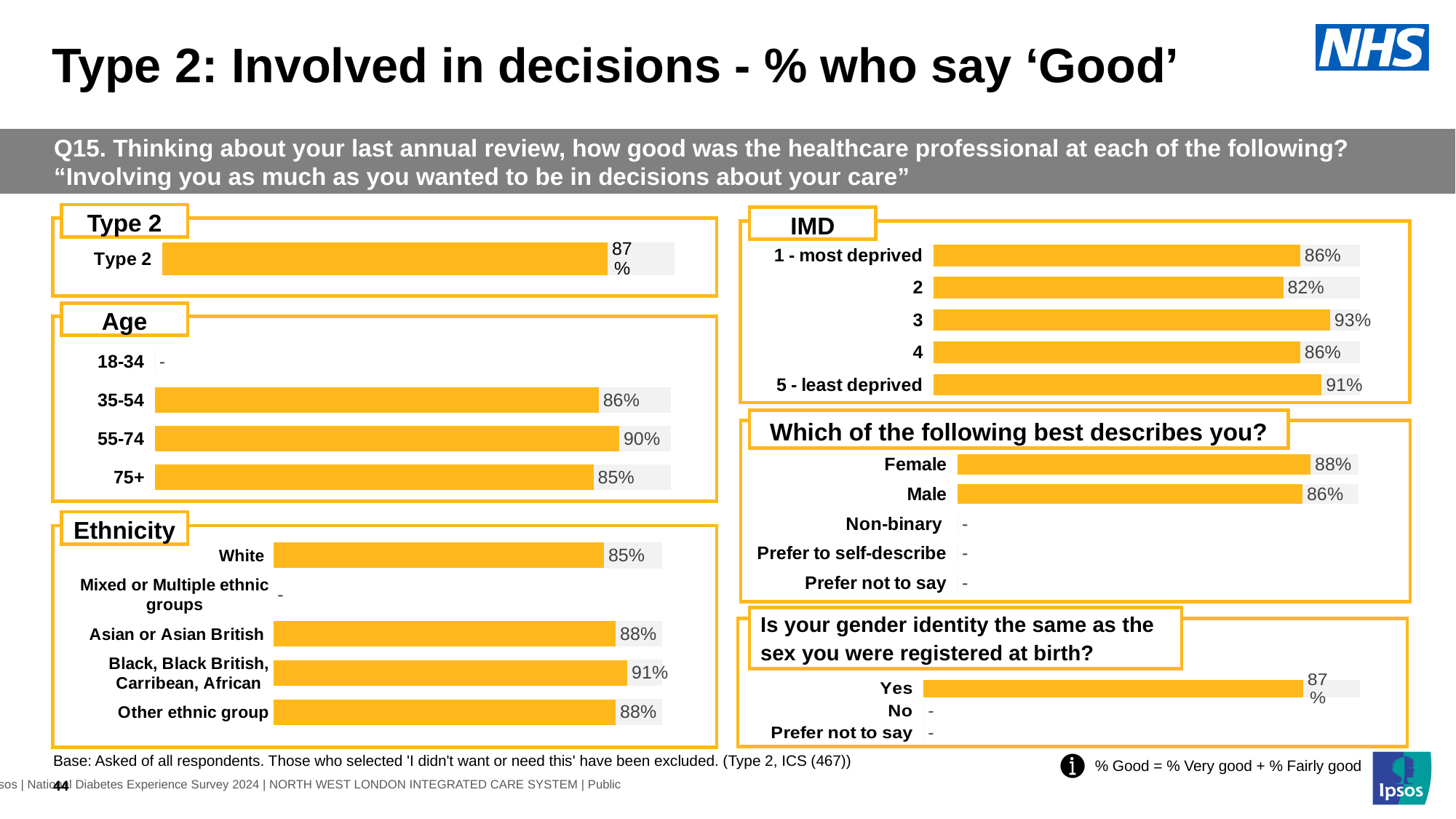
In the 'Which of the following best describes you?' chart, which is larger, Female or Male? Female In the Age chart, which age group with a plotted value has the lowest percentage? 75+ In the Age chart, what is the value for the 55-74 age group? 90% In the Age chart, what is the difference between the 55-74 and 35-54 values? 4 percentage points In the 'Is your gender identity the same as the sex you were registered at birth?' chart, what is the value for Yes? 87% In the IMD chart, what is the difference between the values for 3 and 2? 11 percentage points What type of chart is used in the IMD section? Bar chart In the Ethnicity chart, which ethnic group has the highest percentage? Black, Black British, Carribean, African In the Ethnicity chart, what is the value for White respondents? 85% In the IMD chart, which IMD group has the highest percentage? 3 In the Type 2 chart, what percentage of Type 2 respondents say 'Good'? 87% In the IMD chart, which IMD group has the lowest percentage? 2